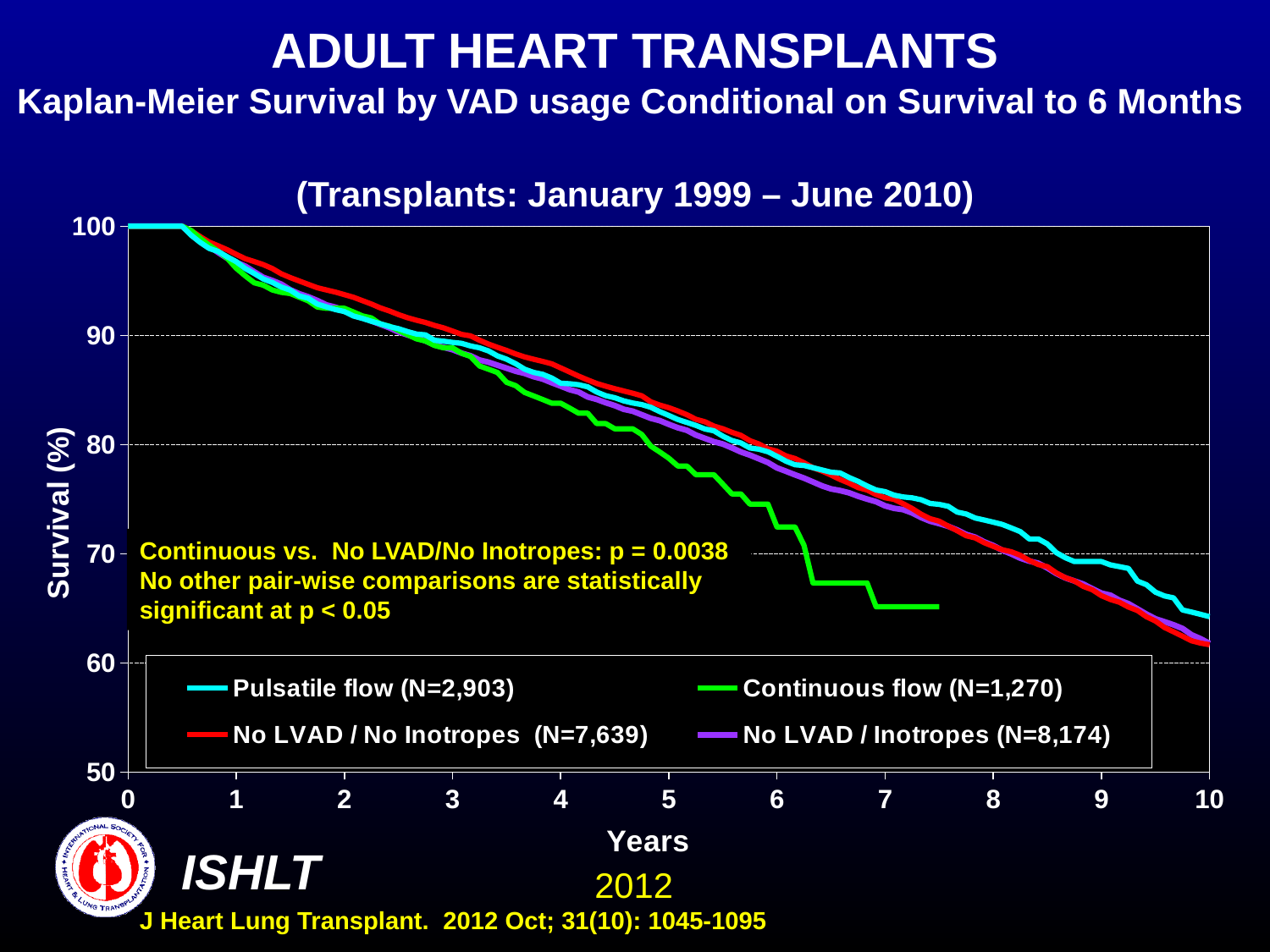
Is the survival value for Pulsatile flow at 10 years greater or less than 60? greater Is the survival value for Pulsatile flow at 8 years greater or less than 70? greater Is the survival value for No LVAD / No Inotropes at 2 years greater or less than 90? greater Which series' curve ends earliest, before reaching 10 years? Continuous flow Which series has the highest survival at 10 years? Pulsatile flow How many series does the legend list? 4 Do the survival curves rise or fall as the years increase? Fall What p-value is given for Continuous vs. No LVAD/No Inotropes? p = 0.0038 What kind of chart is shown on the slide? Line chart What is the N for the Continuous flow group shown in the legend? N=1,270